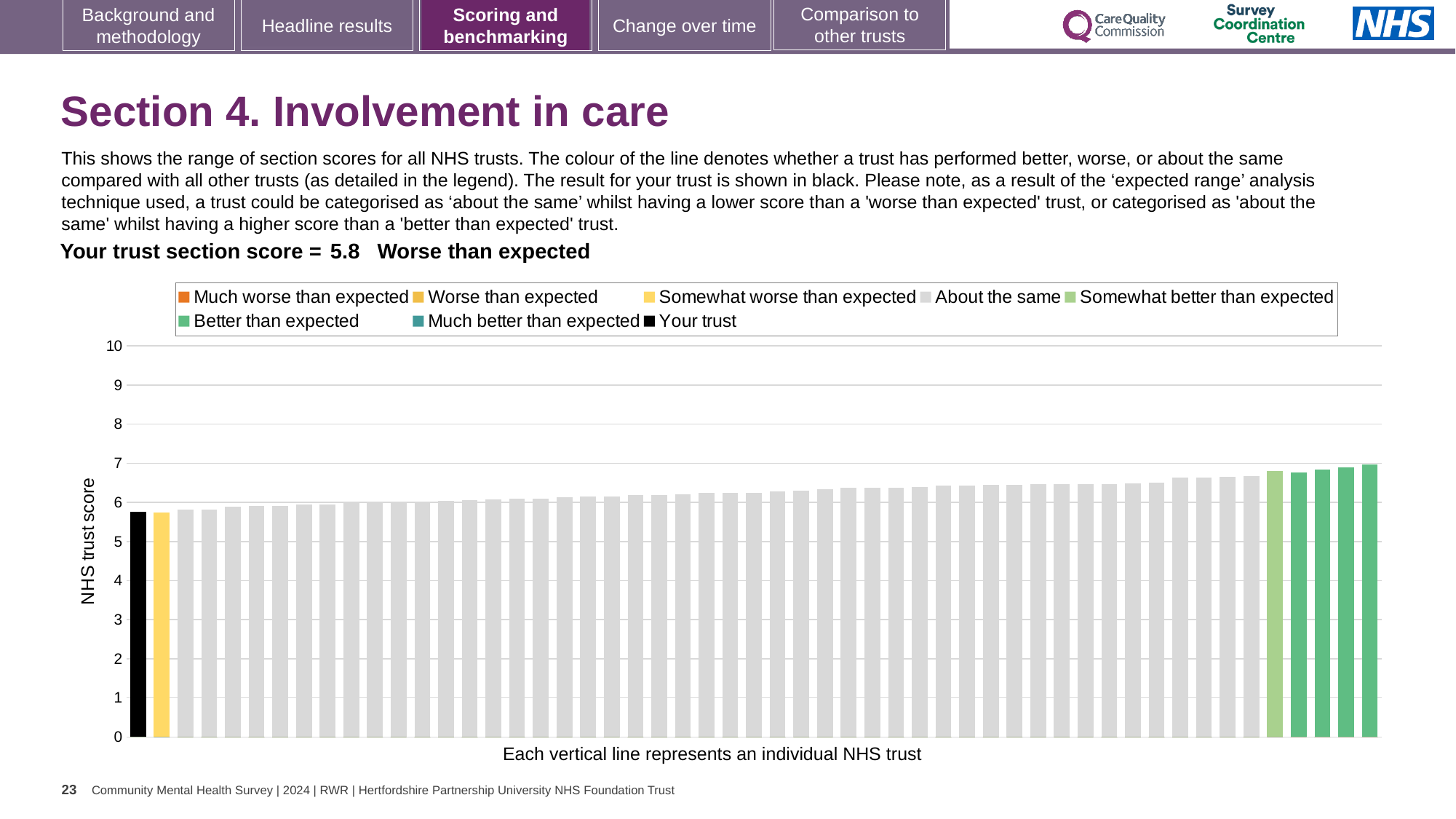
Do the bar values rise or fall from left to right along the x axis? rise Is the value of the tallest bar greater or less than 6? greater What colour is the bar representing your trust? black Which is larger: the value for your trust or the value of the rightmost bar? the rightmost bar What is the section score for your trust? 5.8 Is the value for your trust greater or less than 5? greater Is the value for your trust greater or less than 6? less How many bars are coloured as 'Better than expected' (dark green)? 4 How many entries does the chart legend list? 8 What kind of chart is shown on the slide? bar chart What is the label on the vertical axis of the chart? NHS trust score